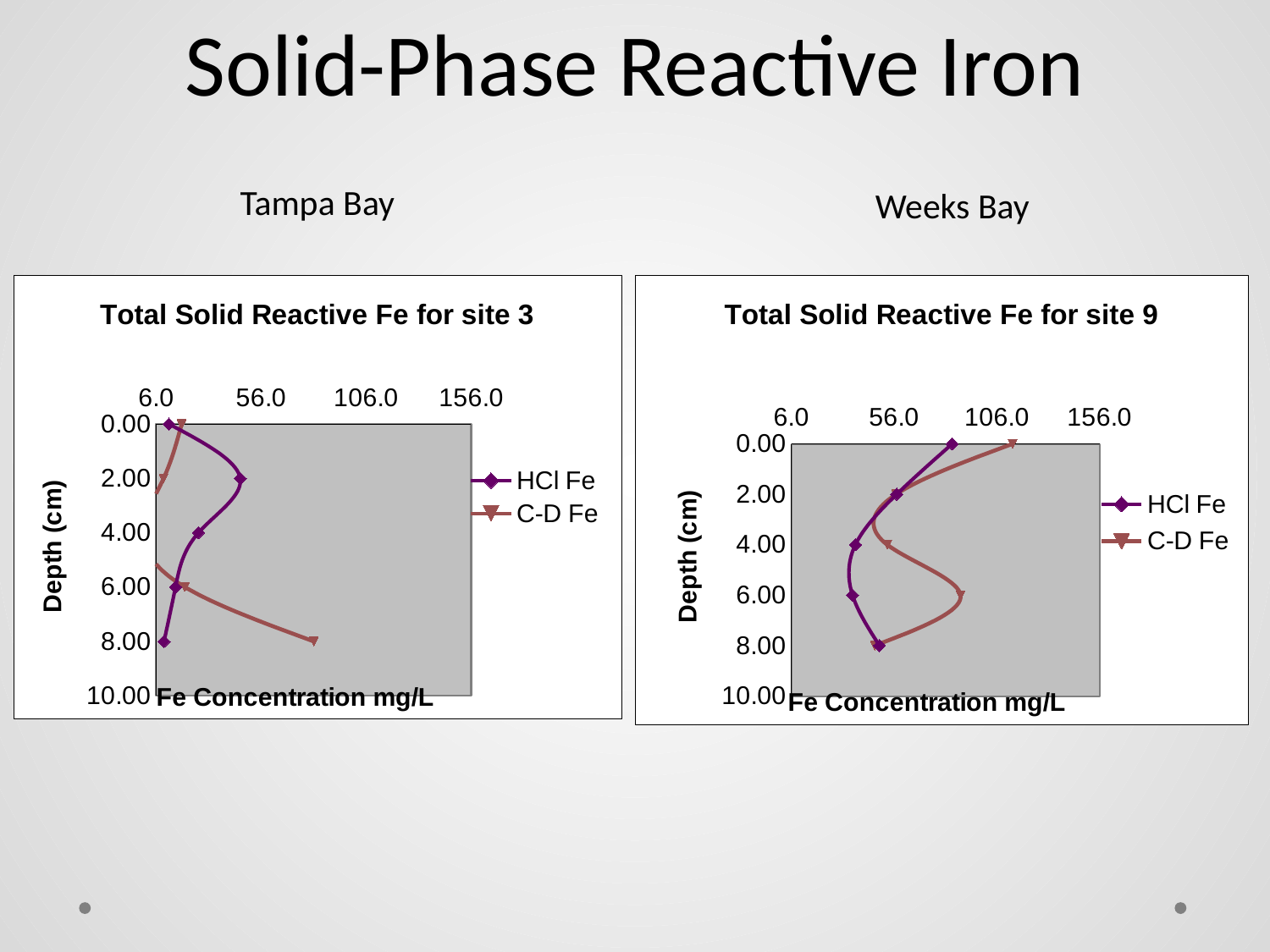
What kind of chart is 'Total Solid Reactive Fe for site 3'? line chart In the 'Total Solid Reactive Fe for site 3' chart, how many data points does the HCl Fe series have? 5 In the 'Total Solid Reactive Fe for site 9' chart, how many data points does the C-D Fe series have? 5 In the 'Total Solid Reactive Fe for site 3' chart, what are the two series named in the legend? HCl Fe and C-D Fe In the 'Total Solid Reactive Fe for site 9' chart, is the HCl Fe concentration at depth 0.00 cm greater or less than 106.0? less What is the x-axis title of the 'Total Solid Reactive Fe for site 9' chart? Fe Concentration mg/L In the 'Total Solid Reactive Fe for site 9' chart, at which depth does the C-D Fe series reach its highest concentration? 0.00 In the 'Total Solid Reactive Fe for site 9' chart, at depth 0.00 cm, which series has the higher Fe concentration, HCl Fe or C-D Fe? C-D Fe In the 'Total Solid Reactive Fe for site 3' chart, at which depth does the HCl Fe series reach its highest concentration? 2.00 In the 'Total Solid Reactive Fe for site 3' chart, is the HCl Fe concentration at depth 2.00 cm greater or less than 56.0? less How many series does the legend list in the 'Total Solid Reactive Fe for site 9' chart? 2 In the 'Total Solid Reactive Fe for site 3' chart, is the C-D Fe concentration at depth 8.00 cm greater or less than 56.0? greater